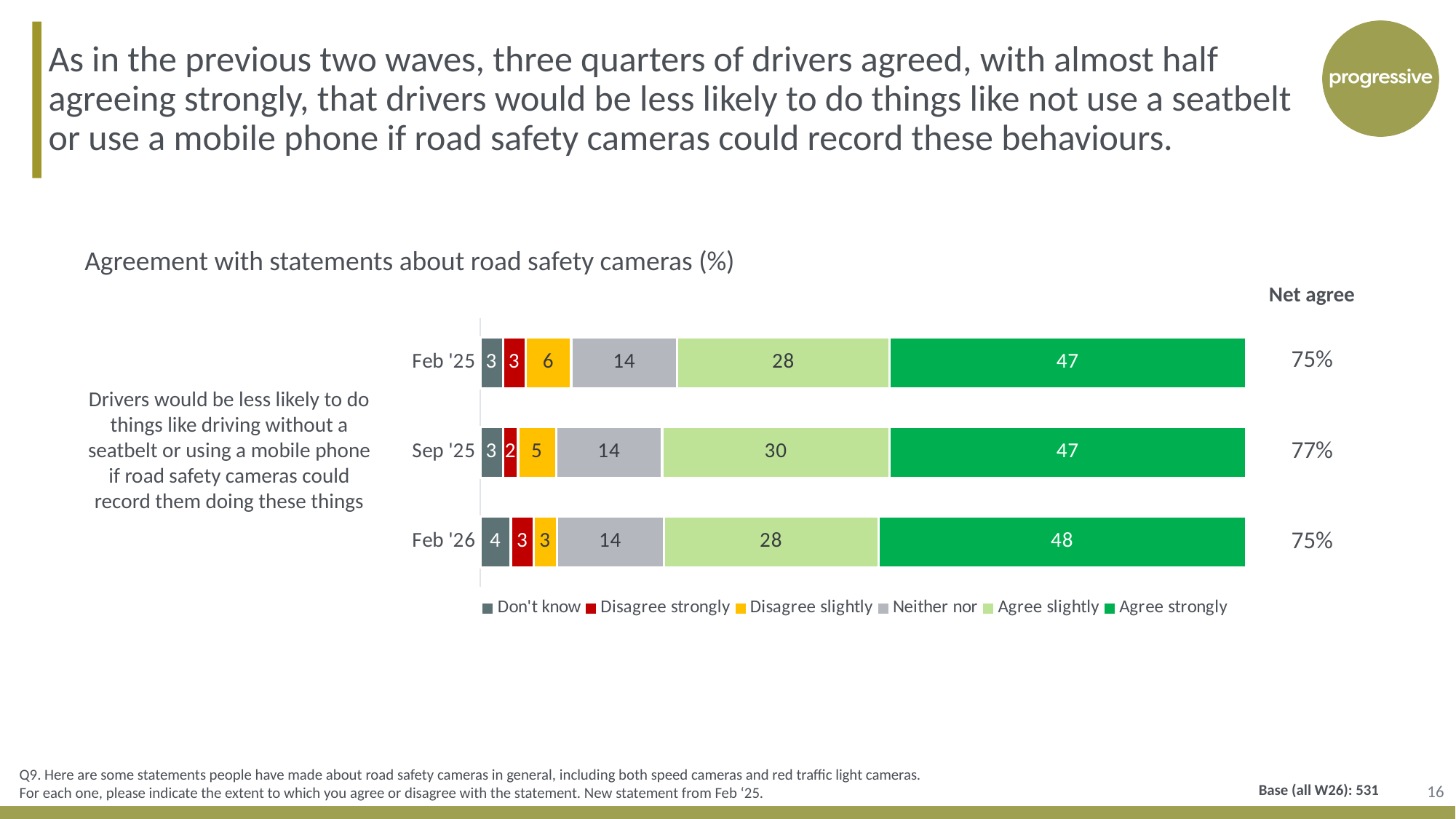
What is the 'Agree slightly' value for Sep '25? 30 What is the 'Disagree slightly' value for Feb '25? 6 How many series does the legend list? 6 What kind of chart is shown on the slide? Stacked bar chart What is the 'Agree strongly' value for Feb '26? 48 What is the title of the chart? Agreement with statements about road safety cameras (%) What is the difference between the 'Agree slightly' values for Sep '25 and Feb '26? 2 What is the 'Don't know' value for Feb '26? 4 Which is larger: the 'Disagree slightly' value for Feb '25 or for Feb '26? Feb '25 Which wave has the highest Net agree percentage? Sep '25 What is the Net agree percentage for Sep '25? 77% How many waves (bars) are plotted in the chart? 3